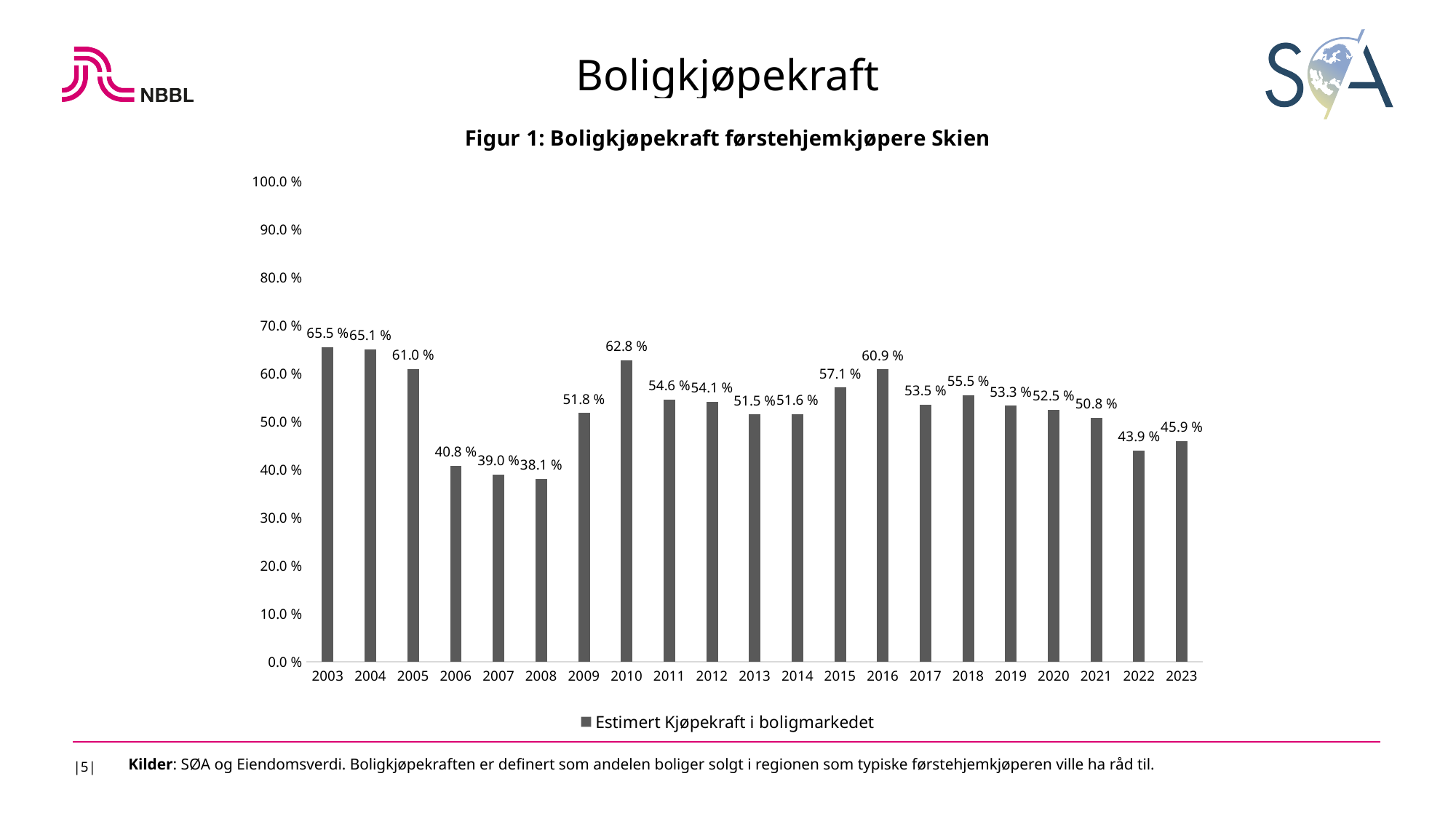
What is the title of the figure? Figur 1: Boligkjøpekraft førstehjemkjøpere Skien What is the value shown for 2008? 38.1 % What kind of chart is shown? bar chart Which year has the highest value? 2003 What is the value shown for 2023? 45.9 % How many years are shown on the x axis? 21 What is the estimated purchasing power value for 2003? 65.5 % How many series does the legend list? 1 Is the value for 2022 greater or less than 50.0 %? less Which year has the lowest value? 2008 What is the difference between the values for 2010 and 2009? 11.0 % Which year has a larger value, 2016 or 2017? 2016